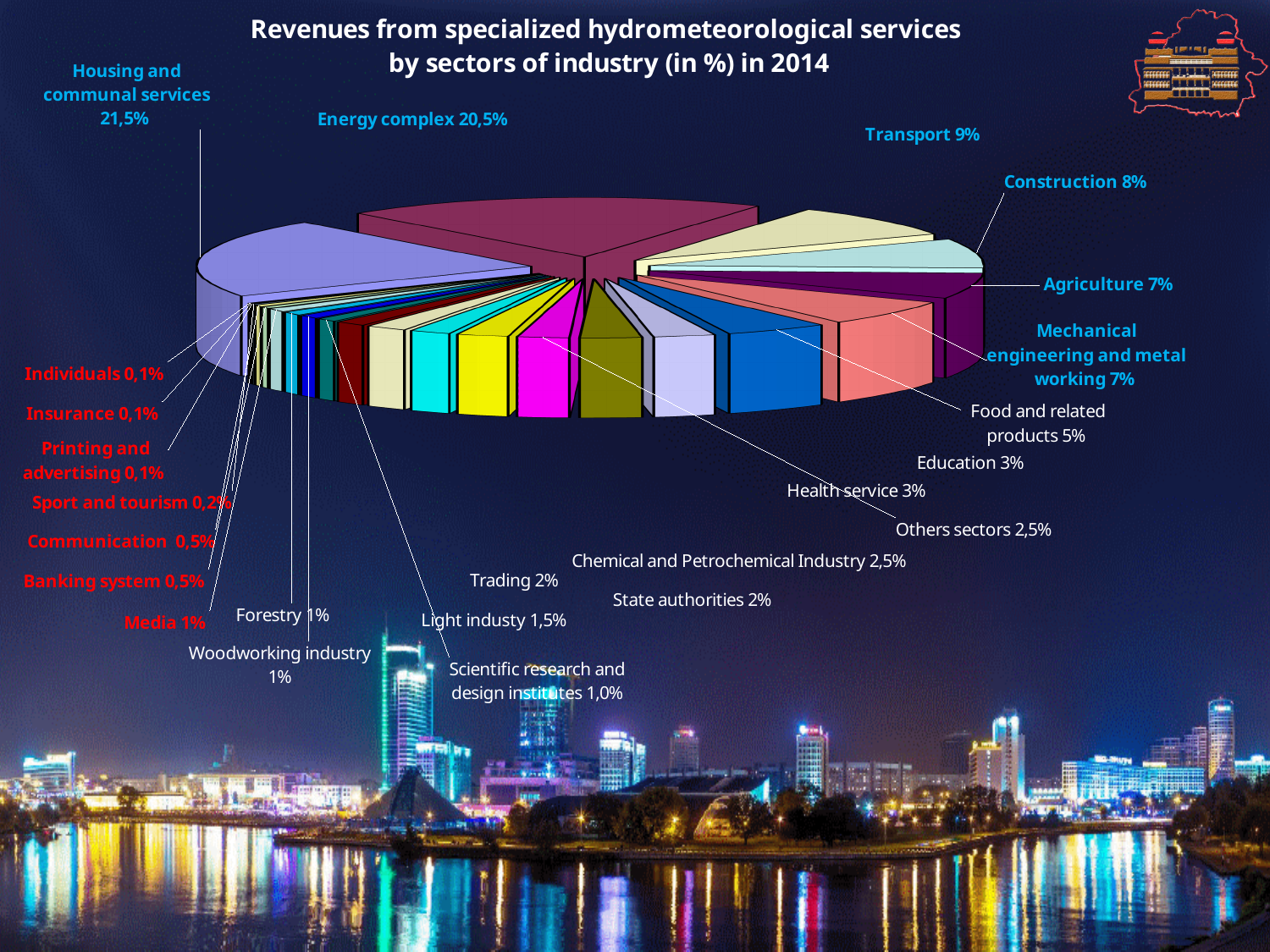
Which is larger, the share for Agriculture or the share for Food and related products? Agriculture What is the difference between the shares of Transport and Construction? 1% What kind of chart is shown on the slide? pie chart What is the value for Scientific research and design institutes? 1,0% What is the value for Food and related products? 5% What is the value for Transport? 9% How many sectors are shown in the pie chart? 24 What is the title of the chart? Revenues from specialized hydrometeorological services by sectors of industry (in %) in 2014 What is the value for Energy complex? 20,5% What share of revenues comes from Housing and communal services? 21,5% What is the difference between the shares of Housing and communal services and Energy complex? 1% Which sector has the largest share of revenues? Housing and communal services